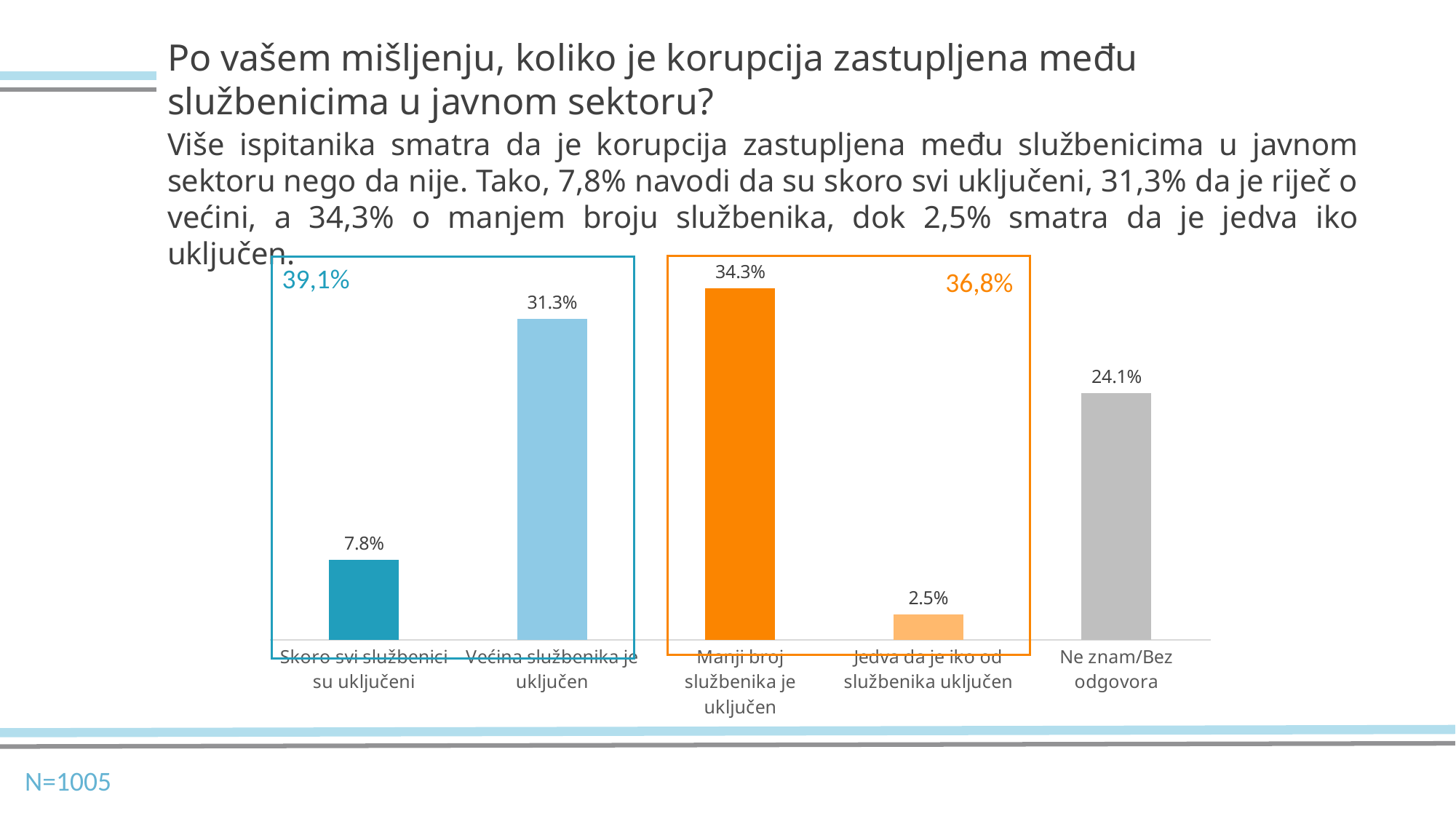
What is the difference between 'Većina službenika je uključen' and 'Skoro svi službenici su uključeni'? 23.5% How many categories are shown in the chart? 5 Which is larger: 'Većina službenika je uključen' or 'Ne znam/Bez odgovora'? Većina službenika je uključen What type of chart is shown on the slide? Bar chart What combined percentage is shown in the orange-outlined box grouping the third and fourth bars? 36,8% What is the value for 'Manji broj službenika je uključen'? 34.3% What is the value for 'Ne znam/Bez odgovora'? 24.1% What combined percentage is shown above the blue-outlined box grouping the first two bars? 39,1% Which category has the lowest value? Jedva da je iko od službenika uključen What is the value for 'Skoro svi službenici su uključeni'? 7.8% What is the value for 'Jedva da je iko od službenika uključen'? 2.5% Which category has the highest value? Manji broj službenika je uključen